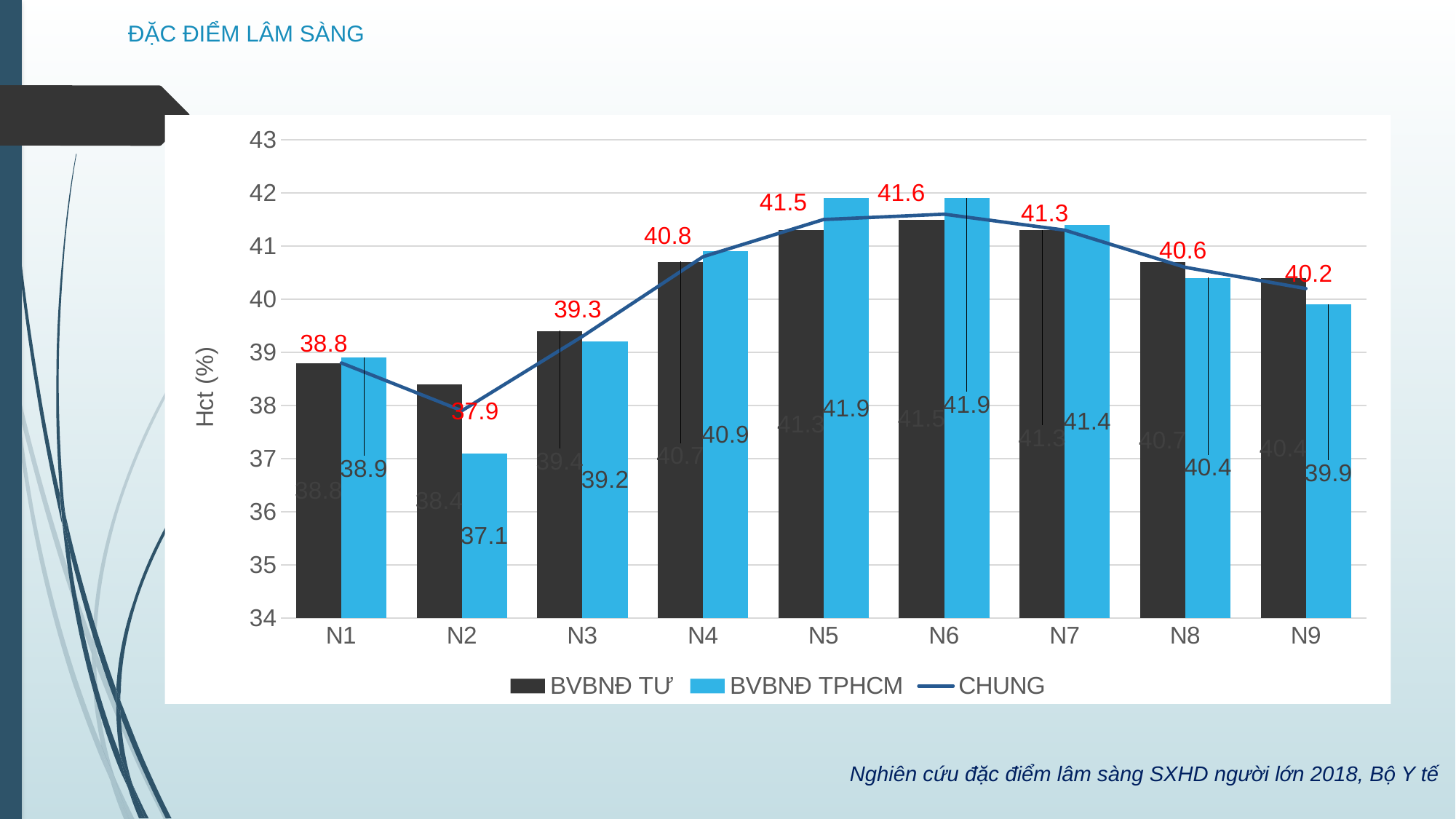
How many series does the legend list? 3 At which day is the CHUNG value highest? N6 What is the label of the y axis? Hct (%) At which day is the BVBNĐ TPHCM value lowest? N2 What is the BVBNĐ TƯ value at N6? 41.5 What is the difference between the BVBNĐ TƯ and BVBNĐ TPHCM values at N2? 1.3 How many days (categories) are shown on the x axis? 9 Which is larger at N9, the BVBNĐ TƯ value or the BVBNĐ TPHCM value? BVBNĐ TƯ What is the CHUNG value at N2? 37.9 Does the CHUNG value rise or fall from N6 to N9? fall What is the CHUNG value at N9? 40.2 What is the BVBNĐ TPHCM value at N5? 41.9